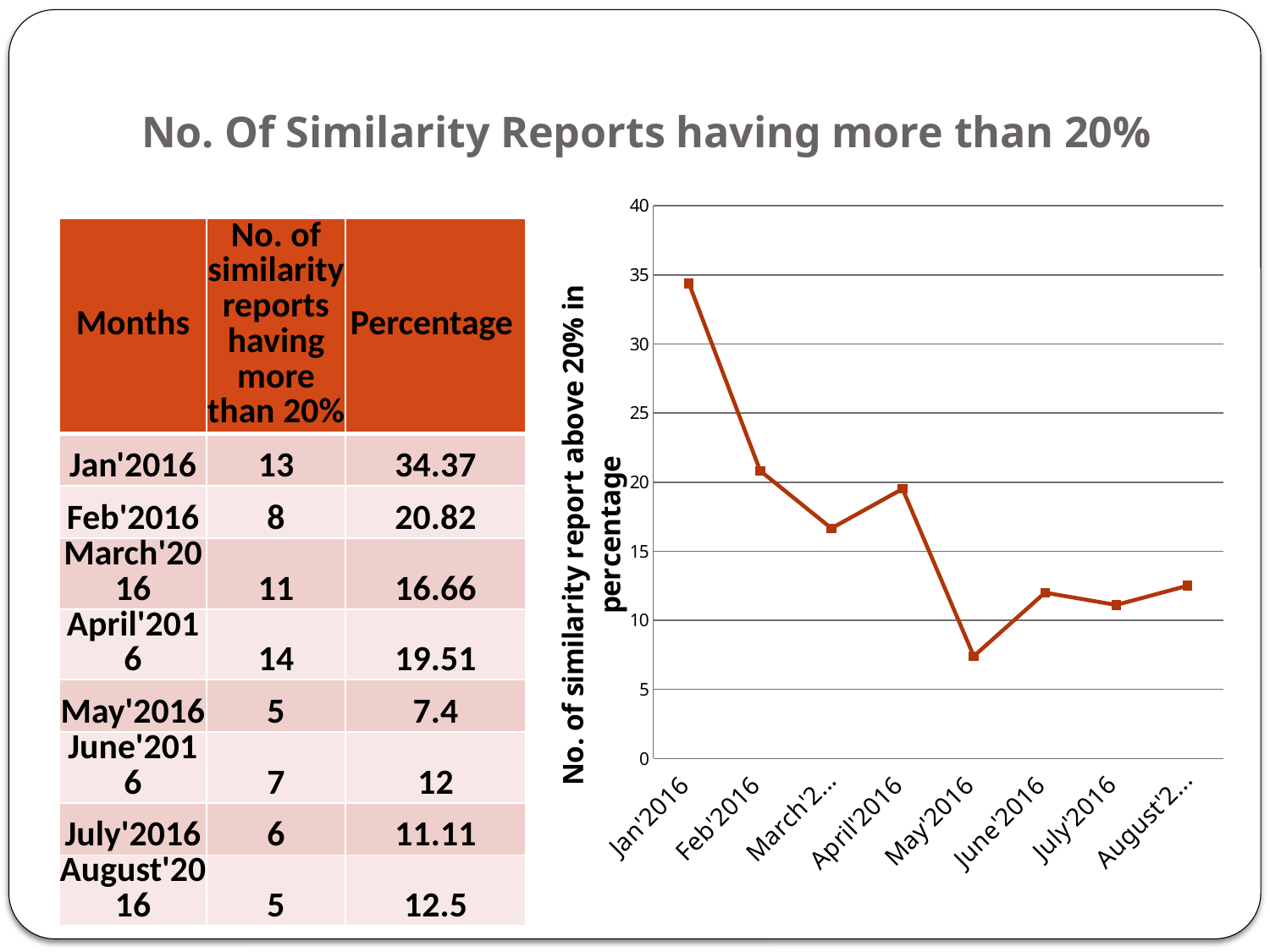
How many months are plotted on the line chart? 8 Which month has the highest percentage on the line chart? Jan'2016 According to the table, how many similarity reports having more than 20% were there in Jan'2016? 13 Does the line rise or fall from Jan'2016 to May'2016? fall Using the table values, what is the difference between the percentage for Jan'2016 and Feb'2016? 13.55 According to the table, what is the percentage for April'2016? 19.51 On the line chart, is the value for May'2016 greater or less than 10? less What kind of chart is shown on the right of the slide? line chart On the line chart, is the value for Jan'2016 greater or less than 30? greater Which month has the lowest percentage on the line chart? May'2016 On the line chart, which is larger, the value for Feb'2016 or the value for March'2016? Feb'2016 What is the title of the vertical axis on the line chart? No. of similarity report above 20% in percentage